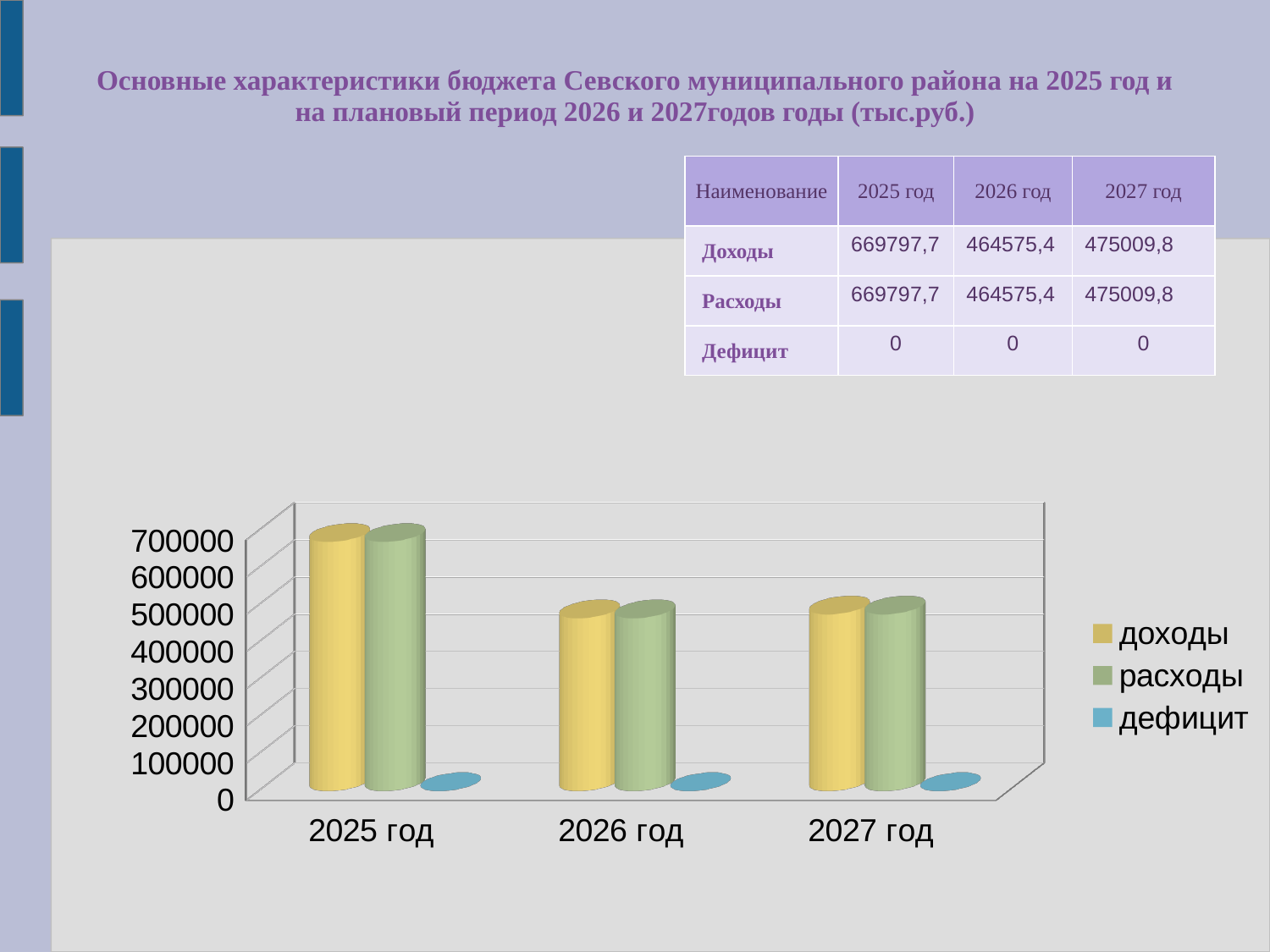
Is the value of доходы for 2025 год greater or less than 600000? greater What is the difference between доходы in 2025 год and доходы in 2026 год? 205222,3 How many year categories are shown on the x axis of the chart? 3 Is the value of расходы for 2026 год greater or less than 500000? less How many series does the chart legend list? 3 What is the value of дефицит for 2027 год? 0 In which year is the value of доходы lowest? 2026 год What is the value of доходы for 2025 год? 669797,7 Which is larger: доходы for 2027 год or доходы for 2026 год? 2027 год What kind of chart is shown on the slide? bar chart In which year is the value of доходы highest? 2025 год What is the value of расходы for 2026 год? 464575,4